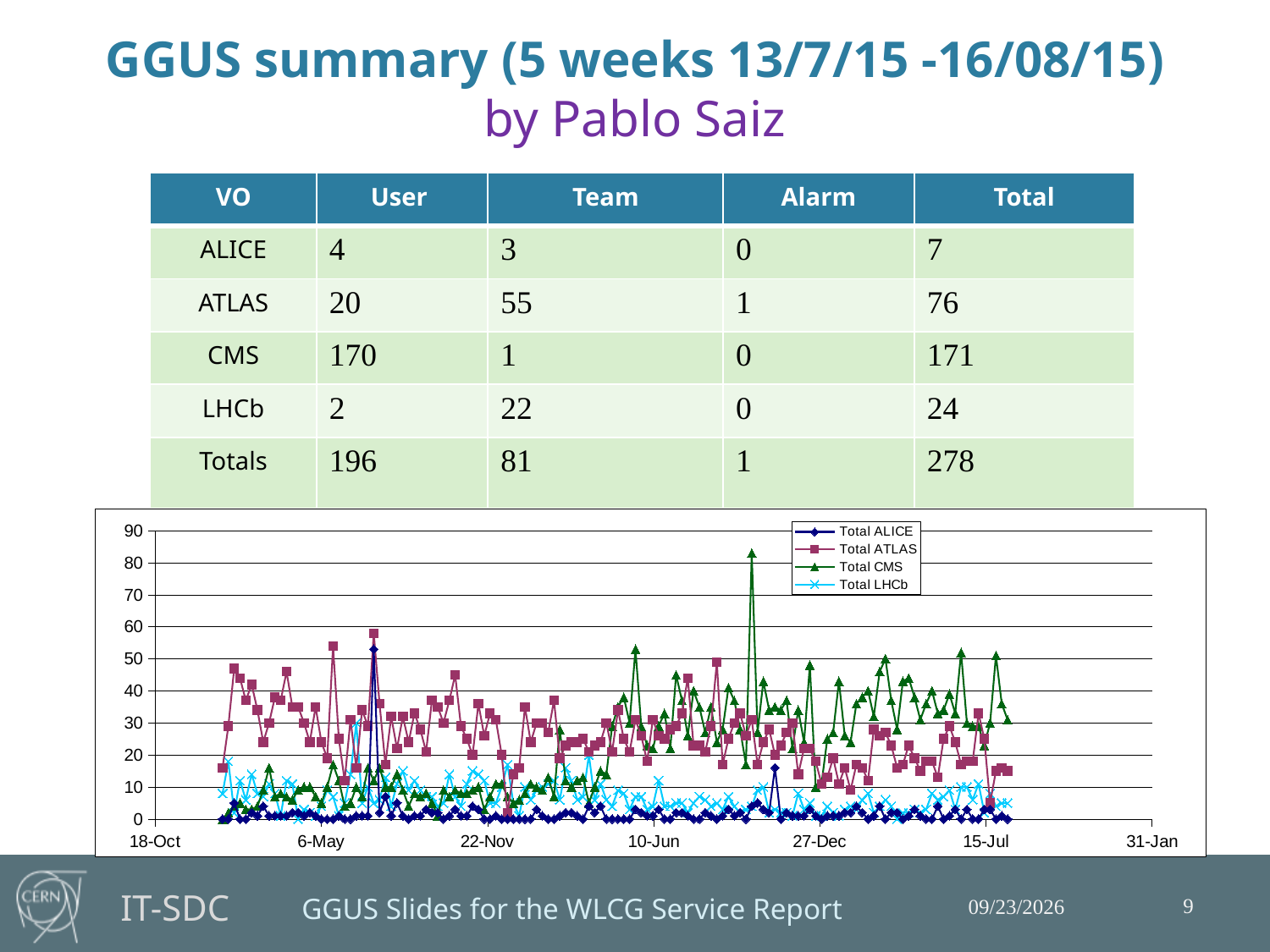
Is the highest peak of the Total ALICE series greater or less than 40? greater Is the highest peak of the Total ATLAS series greater or less than 50? greater Which series has the higher peak value, Total ATLAS or Total LHCb? Total ATLAS What kind of chart is shown at the bottom of the slide? line chart What is the maximum value shown on the chart's vertical axis? 90 Is the highest peak of the Total CMS series greater or less than 80? greater How many date labels are shown along the chart's horizontal axis? 7 Which series in the chart reaches the highest single value? Total CMS How many series does the chart legend list? 4 Which legend entry is listed first in the chart? Total ALICE Which series has the higher peak value, Total CMS or Total ATLAS? Total CMS